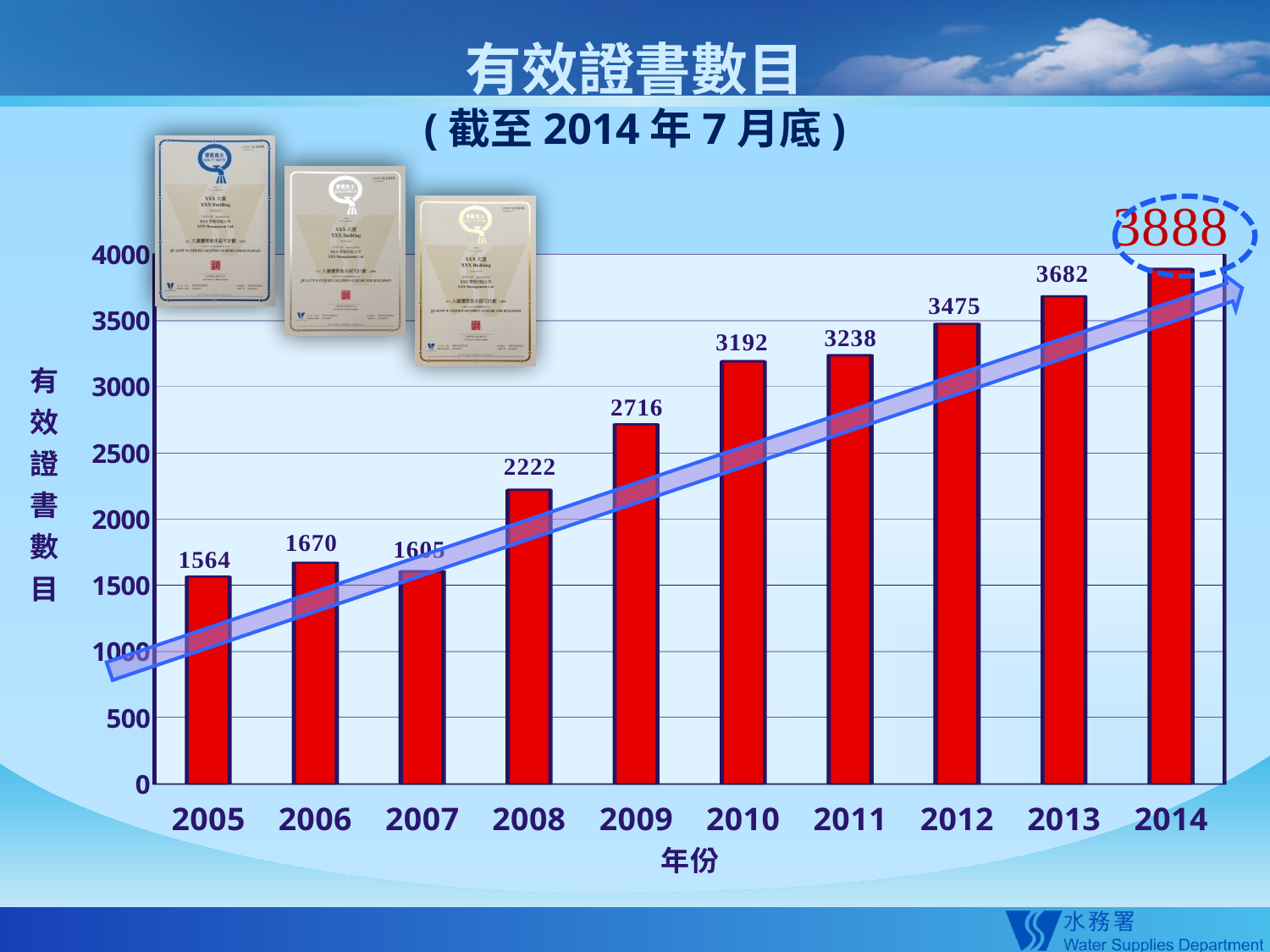
What is the value for 2014? 3888 What kind of chart is shown on the slide? bar chart What is the value for 2005? 1564 Which year has the lowest value? 2005 What is the difference between the values for 2008 and 2007? 617 Is the value for 2012 greater or less than 3500? less How many years are shown on the x axis? 10 Which is larger, the value for 2006 or the value for 2007? 2006 What is the difference between the values for 2014 and 2013? 206 Which year has the highest value? 2014 What is the value for 2009? 2716 Do the values generally rise or fall from 2005 to 2014? rise